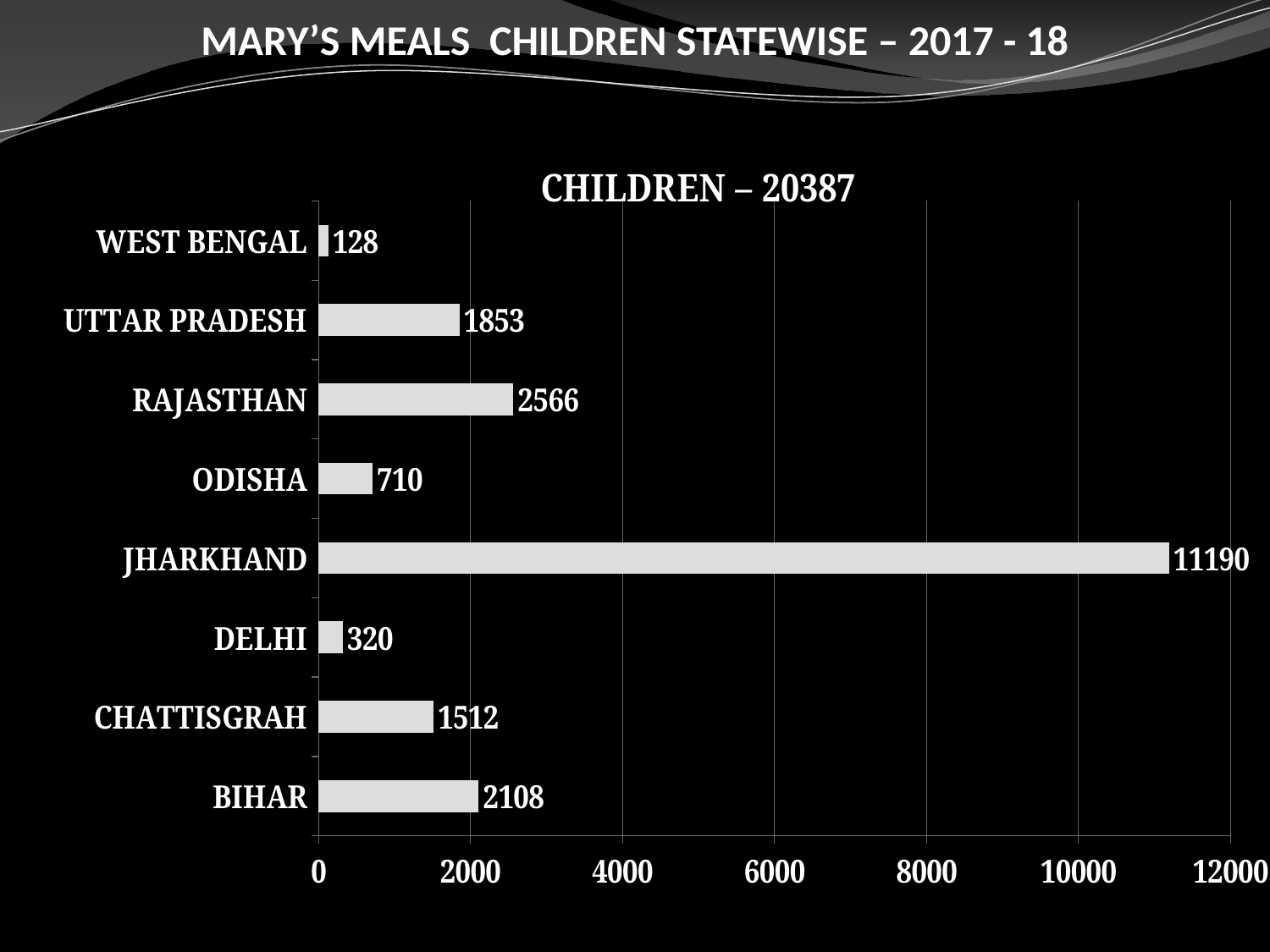
Which state has the lowest number of children? West Bengal What is the value for West Bengal? 128 How many children are shown for Jharkhand? 11190 Is the value for Jharkhand greater or less than 10000? greater Which state has the highest number of children? Jharkhand What kind of chart is shown on the slide? bar chart What is the title of the chart? CHILDREN – 20387 What is the difference between the values for Bihar and Chattisgrah? 596 What is the difference between the values for Odisha and Delhi? 390 What is the value for Rajasthan? 2566 How many states are shown in the chart? 8 Which is larger, the value for Uttar Pradesh or the value for Rajasthan? Rajasthan